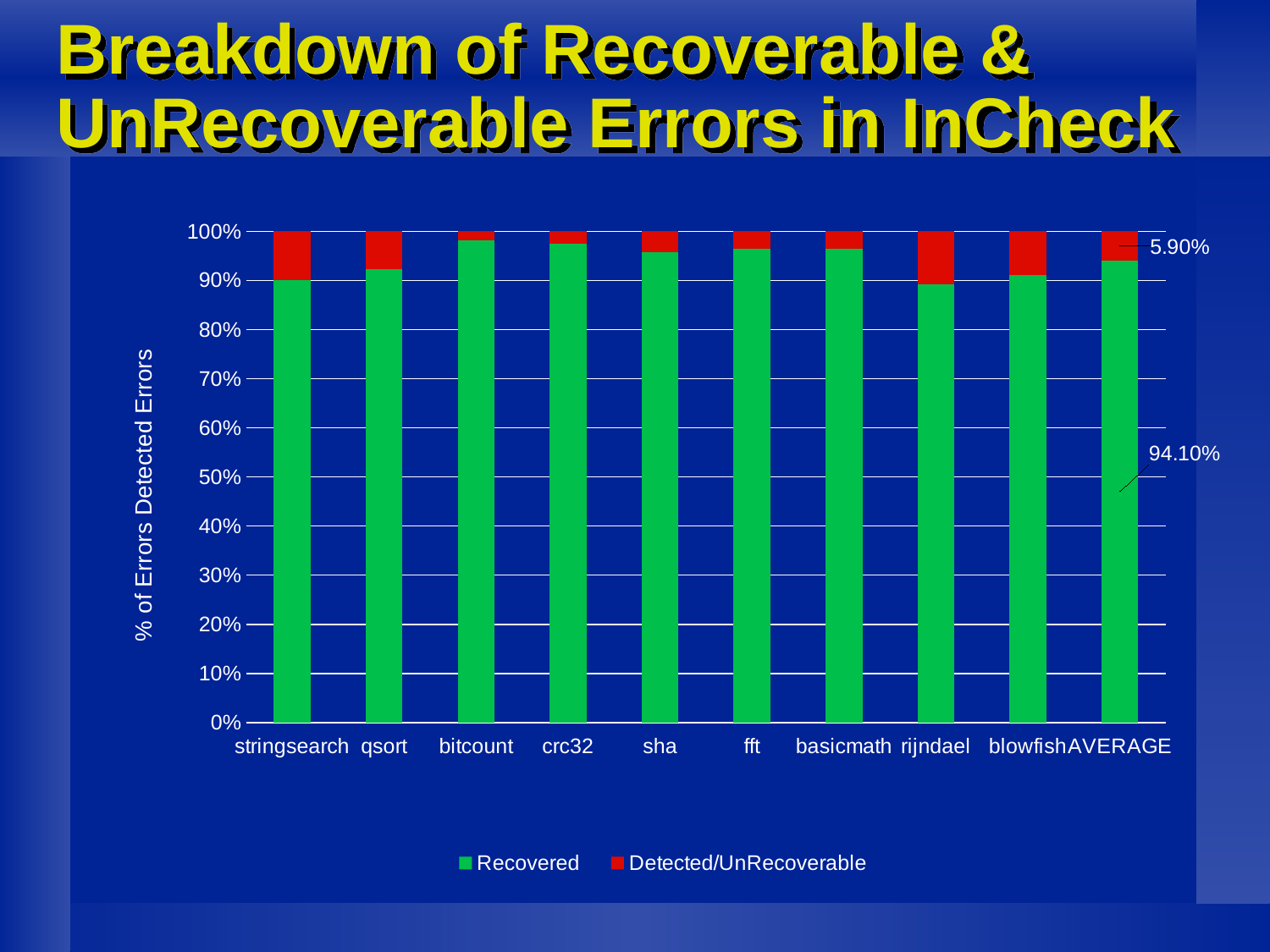
How many series does the legend list? 2 Which has a larger Detected/UnRecoverable share, stringsearch or bitcount? stringsearch Which category has the lowest Recovered share? rijndael Which category has the highest Recovered share? bitcount What is the Recovered value for AVERAGE? 94.10% What type of chart is shown on the slide? stacked bar chart What is the label of the y axis? % of Errors Detected Errors How many categories are shown along the x axis? 10 Which colour represents the Recovered series? green Is the Recovered value for qsort greater or less than 90%? greater What is the Detected/UnRecoverable value for AVERAGE? 5.90%